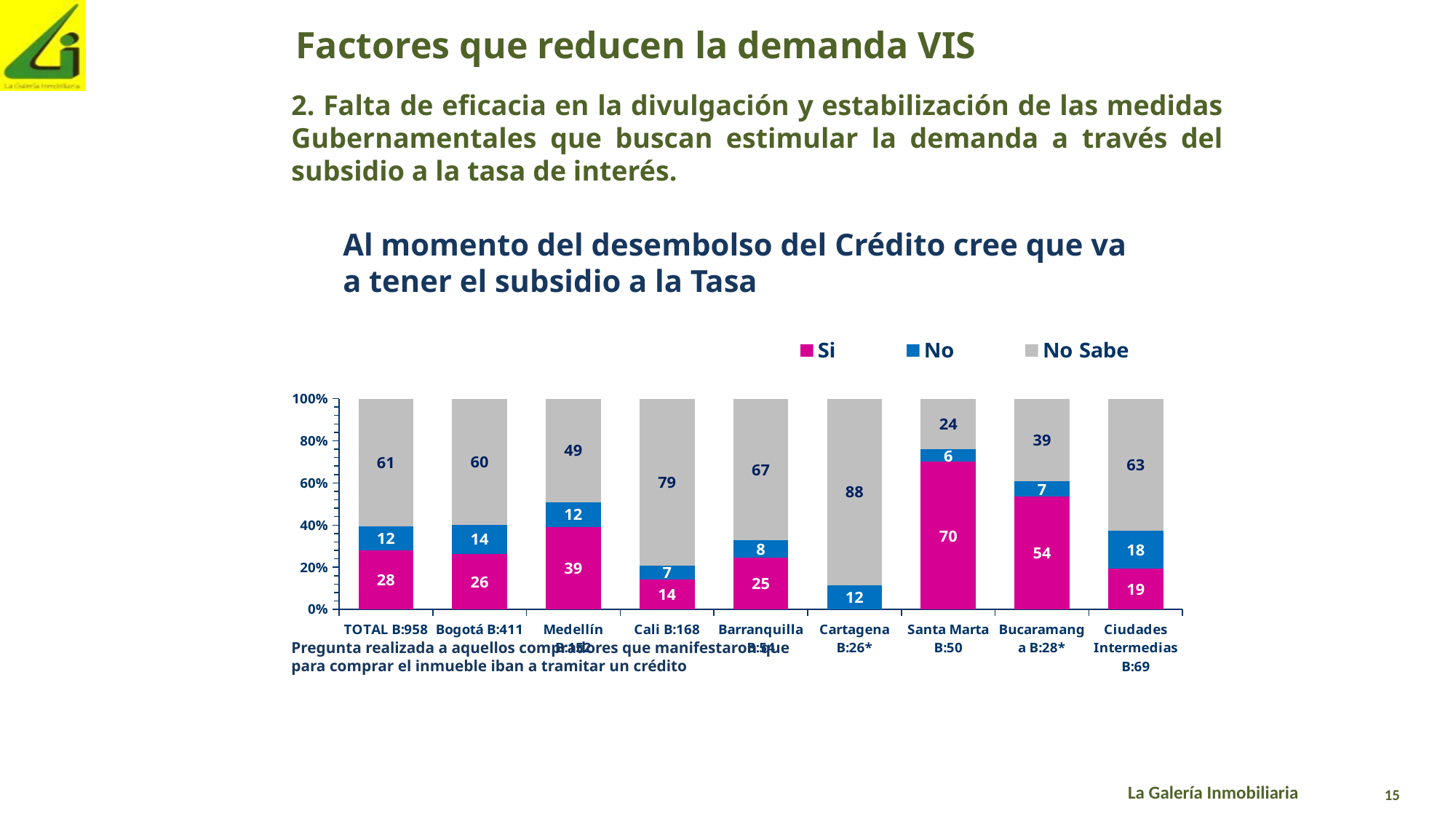
How many series does the legend list? 3 What is the 'No' value for Bogotá B:411? 14 What is the difference between the 'No Sabe' values for Cartagena B:26* and Bucaramanga a B:28*? 49 What is the 'No Sabe' value for Cali B:168? 79 Which category has the lowest 'No Sabe' value? Santa Marta B:50 Which is larger, the 'Si' value for Bogotá B:411 or for TOTAL B:958? TOTAL B:958 How many categories (bars) are shown on the x axis? 9 Which category has the highest 'Si' value? Santa Marta B:50 What is the 'No' value for Ciudades Intermedias B:69? 18 What type of chart is shown on the slide? Stacked bar chart What is the 'Si' value for Santa Marta B:50? 70 Which series is shown in magenta in the legend? Si